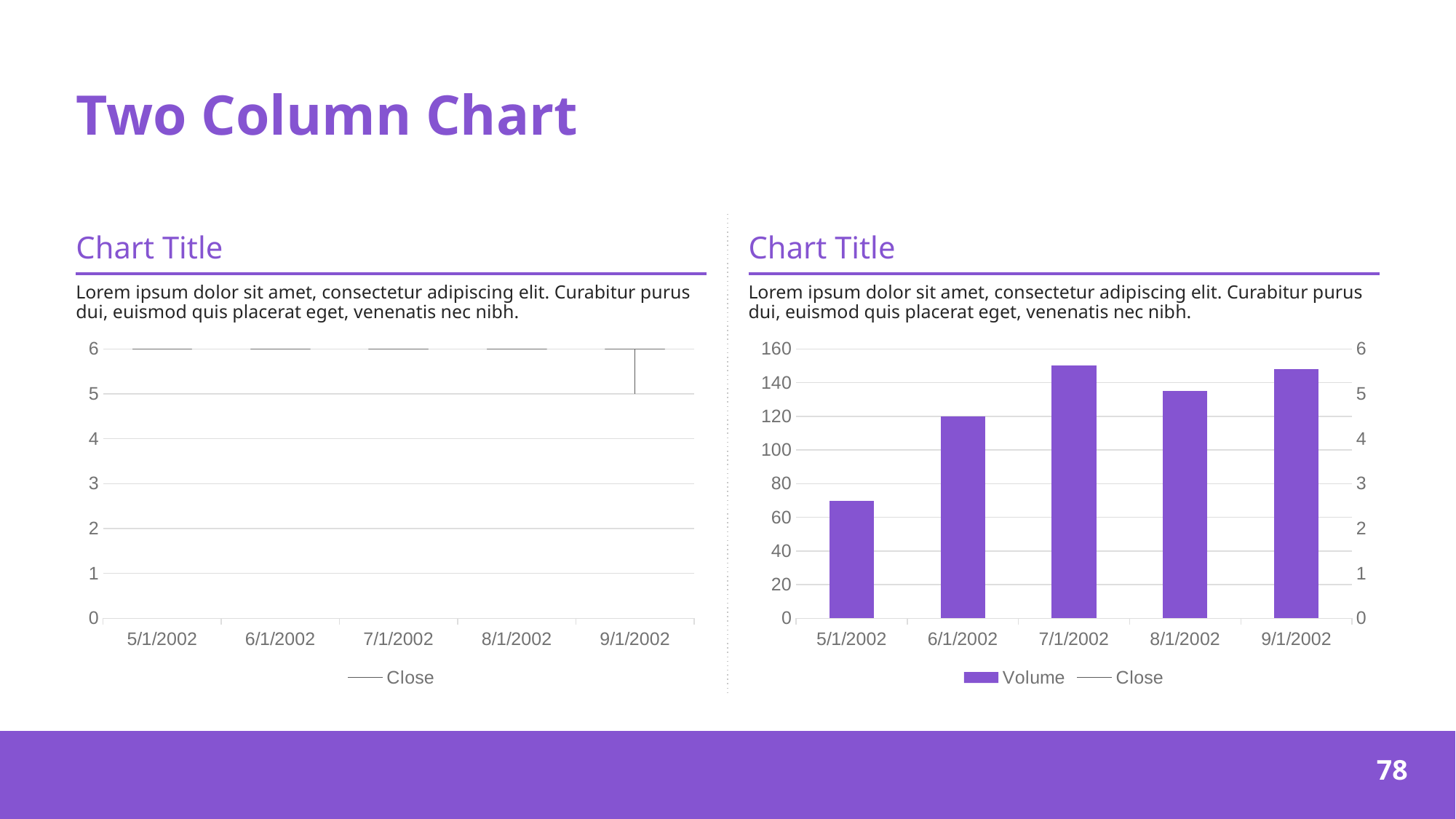
What kind of chart is the chart on the right side of the slide? bar chart How many series does the legend of the right-hand chart list? 2 What is the name of the series shown in the legend of the left-hand chart? Close In the right-hand chart, which date has the shortest Volume bar? 5/1/2002 How many series does the legend of the left-hand chart list? 1 In the right-hand chart, which has the larger Volume bar, 6/1/2002 or 8/1/2002? 8/1/2002 In the right-hand chart, is the Volume value for 7/1/2002 greater or less than 140? greater What is the highest value shown on the left vertical axis of the right-hand chart? 160 How many dates are shown on the x axis of the right-hand chart? 5 In the right-hand chart, which date has the tallest Volume bar? 7/1/2002 In the right-hand chart, is the Volume value for 5/1/2002 greater or less than 80? less In the right-hand chart, what is the Volume value for 6/1/2002? 120